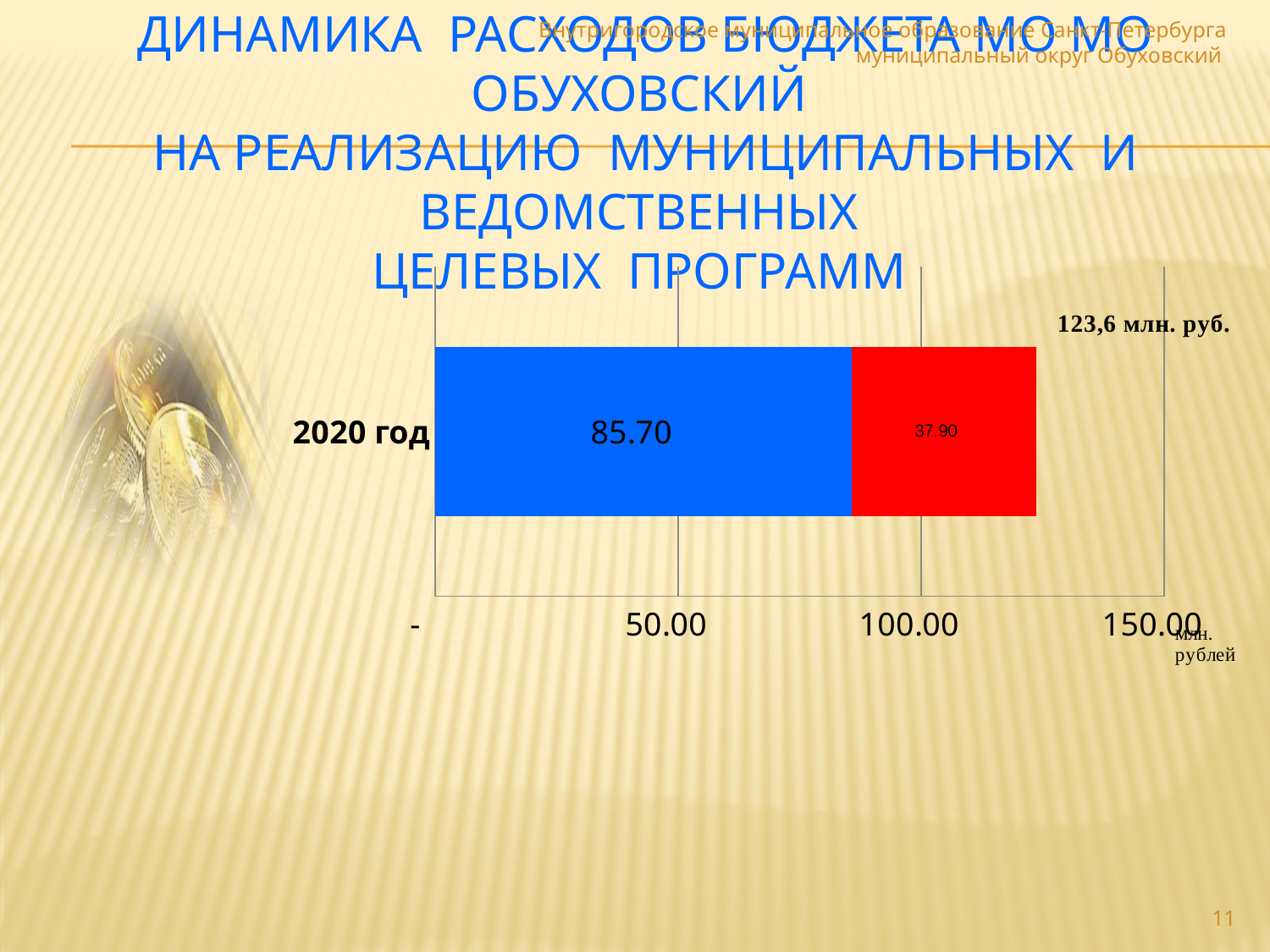
How many segments make up the stacked bar for 2020 год? 2 Which segment of the 2020 год bar is larger, the blue one or the red one? the blue one How many categories (years) are plotted on the chart? 1 What is the total of the stacked bar for 2020 год, as labelled on the slide? 123,6 млн. руб. What is the value of the blue segment of the bar for 2020 год? 85.70 What is the difference between the blue segment (85.70) and the red segment (37.90) of the 2020 год bar? 47.80 Is the blue segment of the 2020 год bar greater or less than 50.00? greater What kind of chart is shown on the slide? bar chart What unit is indicated at the end of the horizontal axis? млн. рублей What is the category label shown on the vertical axis of the chart? 2020 год Is the total length of the 2020 год bar greater or less than 100.00? greater What is the value of the red segment of the bar for 2020 год? 37.90